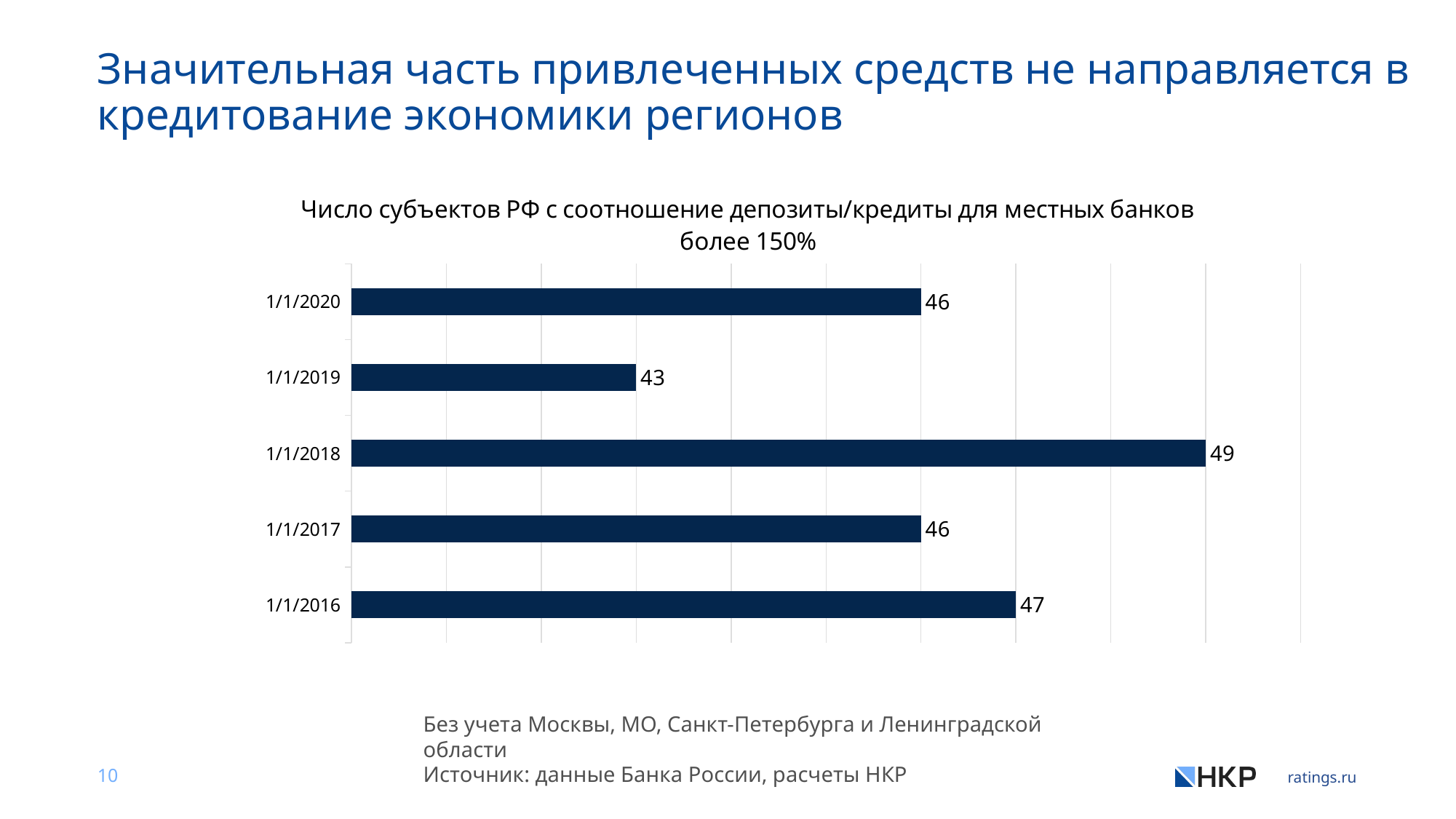
How many dates are shown on the chart? 5 What is the value for 1/1/2018? 49 What is the value for 1/1/2016? 47 What is the difference between the values for 1/1/2018 and 1/1/2019? 6 What is the title of the chart? Число субъектов РФ с соотношение депозиты/кредиты для местных банков более 150% Which date has the highest value? 1/1/2018 Which is larger, the value for 1/1/2016 or the value for 1/1/2017? 1/1/2016 What is the difference between the values for 1/1/2016 and 1/1/2020? 1 What is the value for 1/1/2019? 43 What kind of chart is shown on the slide? bar chart What is the value for 1/1/2020? 46 Which date has the lowest value? 1/1/2019